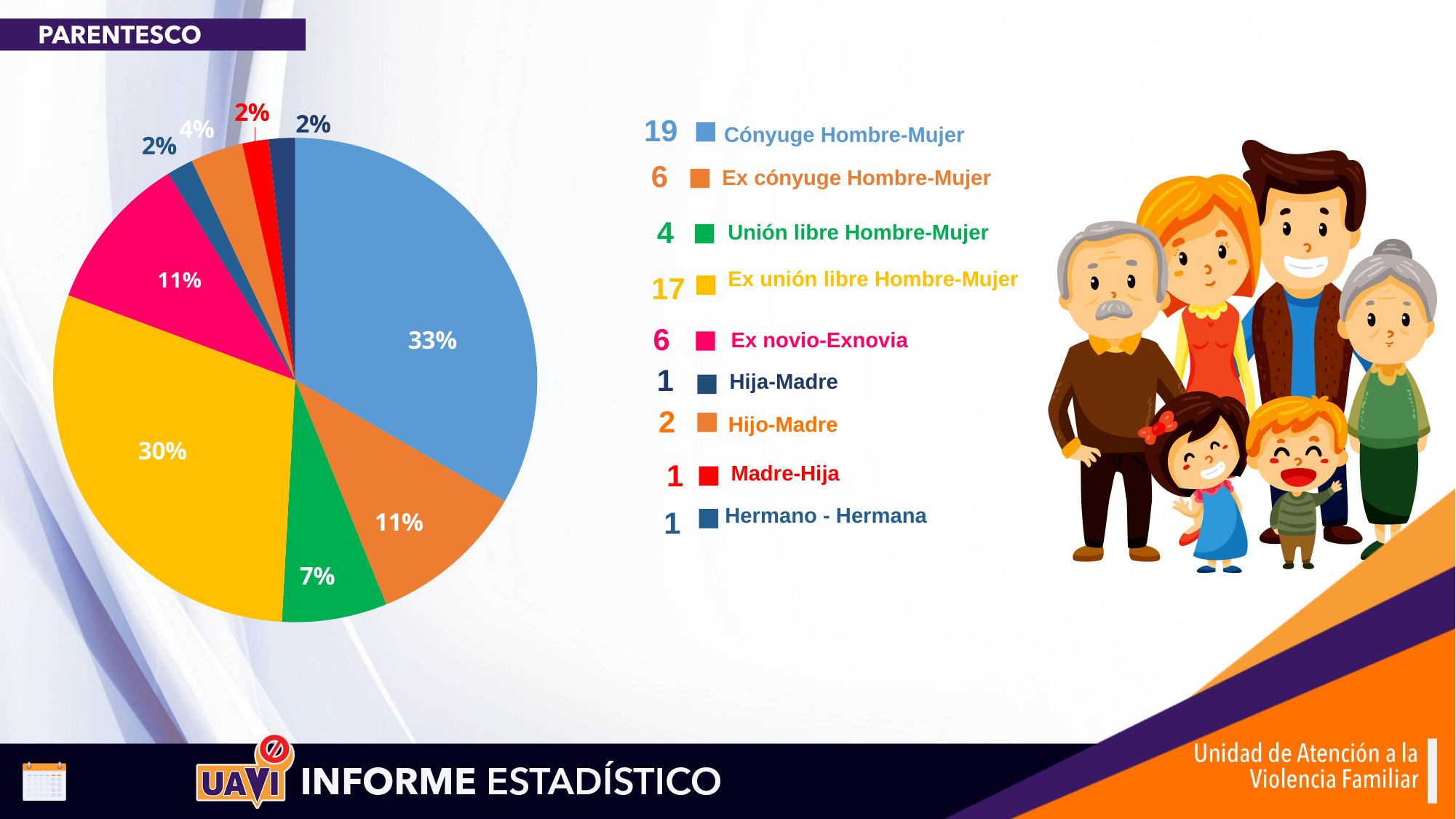
Which has more cases, Ex cónyuge Hombre-Mujer or Unión libre Hombre-Mujer? Ex cónyuge Hombre-Mujer How many cases are listed for Hijo-Madre in the legend? 2 What percentage of the pie does Ex unión libre Hombre-Mujer represent? 30% What percentage of the pie does Unión libre Hombre-Mujer represent? 7% Which category has the largest slice of the pie? Cónyuge Hombre-Mujer How many categories are listed in the legend of the pie chart? 9 What type of chart is shown on the PARENTESCO slide? Pie chart What percentage of the pie does Cónyuge Hombre-Mujer represent? 33% What is the total number of cases across all categories in the legend? 57 How many cases are listed for Ex novio-Exnovia in the legend? 6 What colour is the slice for Ex unión libre Hombre-Mujer? Yellow What is the difference in cases between Cónyuge Hombre-Mujer and Ex unión libre Hombre-Mujer? 2